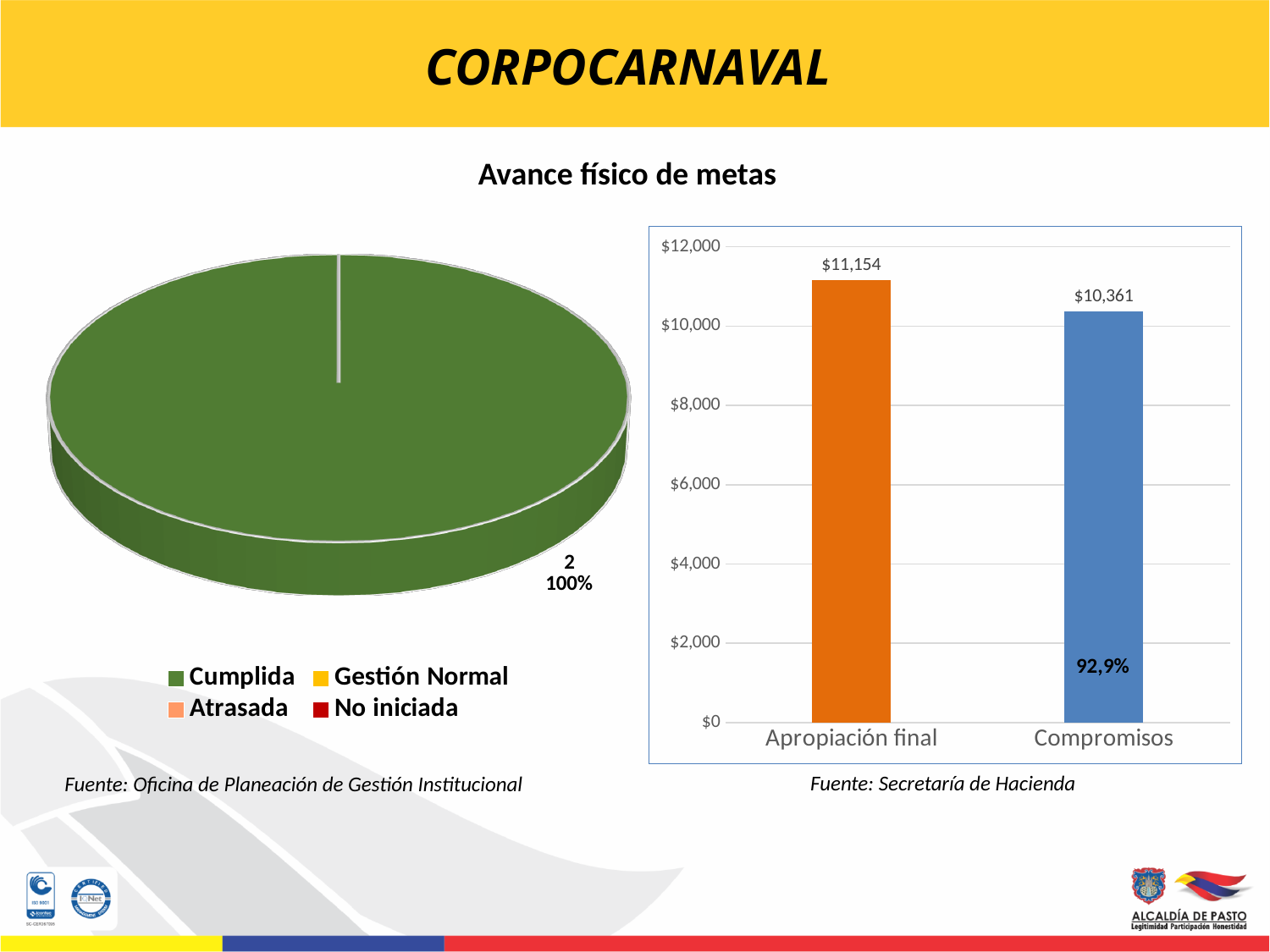
In the bar chart on the right, how many categories are shown on the x axis? 2 What kind of chart is shown on the left side of the slide? Pie chart In the bar chart on the right, what is the value for Compromisos? $10,361 In the pie chart on the left, what share does the Cumplida slice represent? 100% What kind of chart is shown on the right side of the slide? Bar chart In the bar chart on the right, what percentage label is printed on the Compromisos bar? 92,9% How many entries does the legend of the pie chart on the left list? 4 In the bar chart on the right, what is the difference between Apropiación final and Compromisos? $793 In the bar chart on the right, which category has the higher value, Apropiación final or Compromisos? Apropiación final In the bar chart on the right, which category has the lowest value? Compromisos In the pie chart on the left, what count is printed on the Cumplida slice? 2 In the bar chart on the right, what is the value for Apropiación final? $11,154